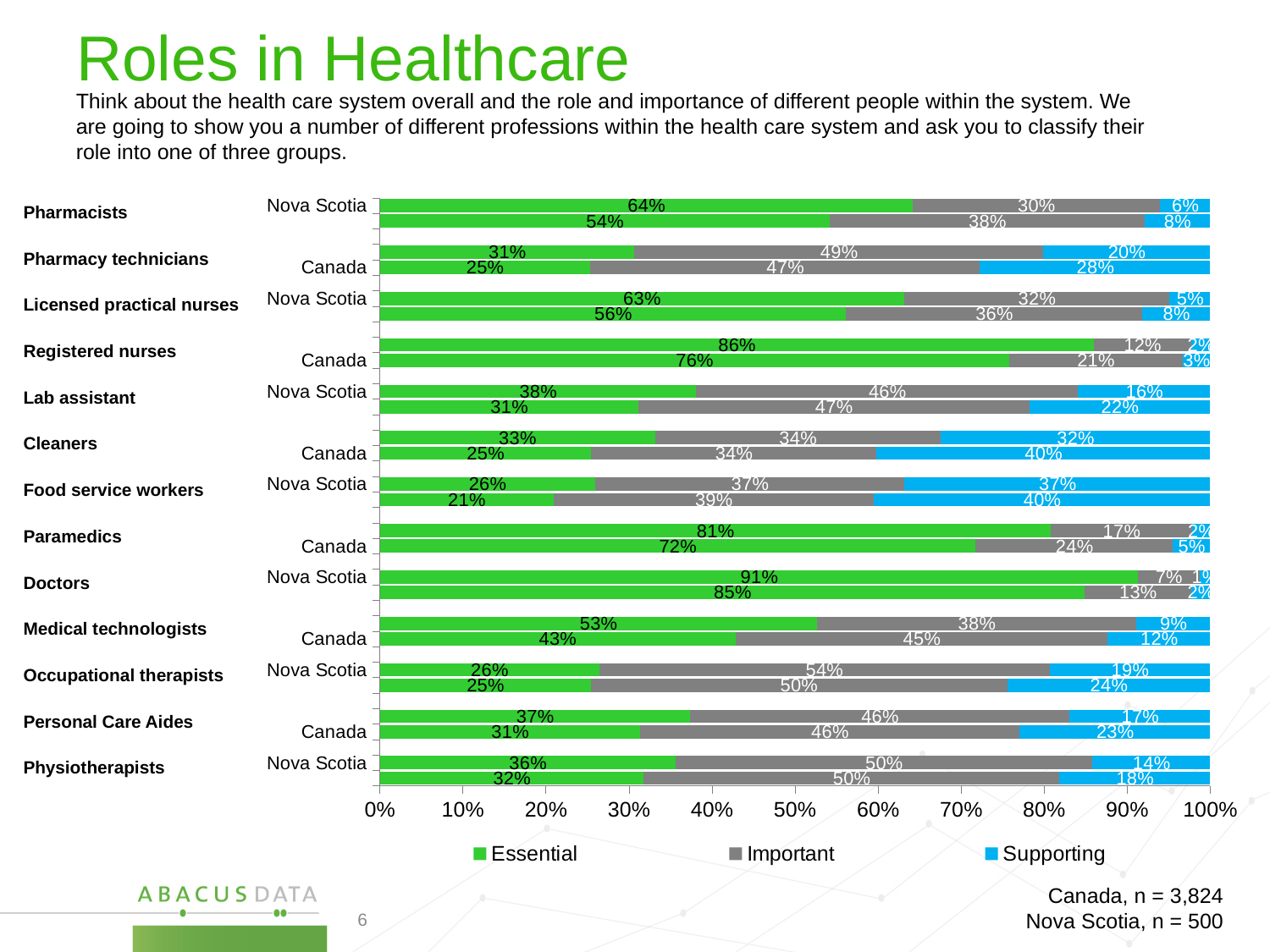
What colour represents the Supporting series in the legend? Blue Which profession has the lowest Essential percentage among Canada respondents? Food service workers Which profession has the highest Essential percentage among Nova Scotia respondents? Doctors How many professions are listed on the chart? 13 How many series does the legend list? 3 What is the difference between the Nova Scotia and Canada Essential percentages for Registered nurses? 10% What percentage of Nova Scotia respondents classified Occupational therapists as Important? 54% What percentage of Canada respondents classified Cleaners as Supporting? 40% Which is larger: the Essential percentage for Paramedics in Nova Scotia or in Canada? Nova Scotia What kind of chart is shown on the slide? Stacked bar chart What percentage of Canada respondents classified Pharmacists as Important? 38% What percentage of Nova Scotia respondents classified Doctors as Essential? 91%